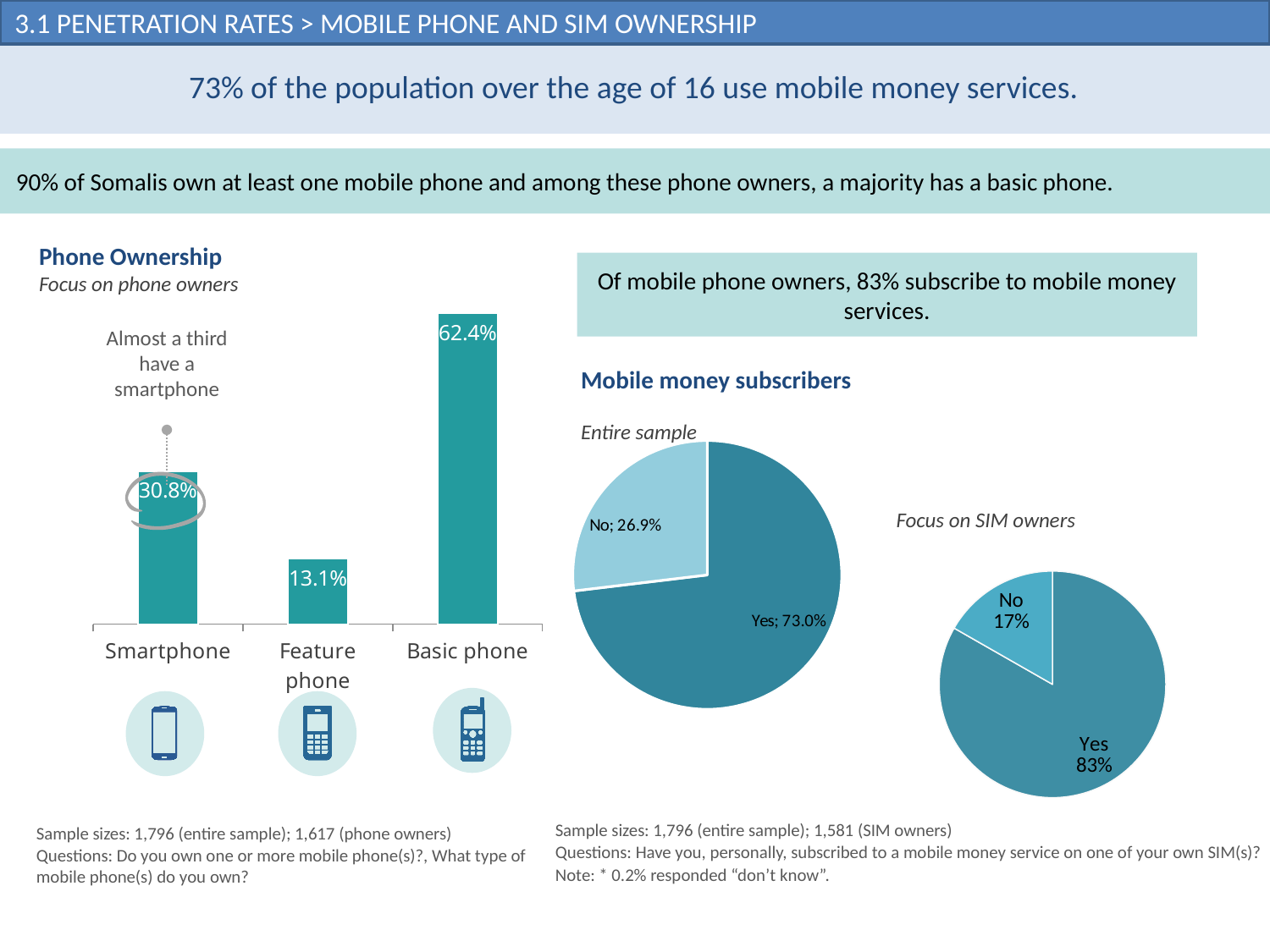
In the Phone Ownership bar chart, which phone type has the highest share? Basic phone In the Phone Ownership bar chart, what is the value for Feature phone? 13.1% In the Phone Ownership bar chart, how many phone types are shown? 3 In the Mobile money subscribers 'Entire sample' pie chart, what share answered No? 26.9% In the 'Focus on SIM owners' pie chart, which slice is larger, Yes or No? Yes In the 'Focus on SIM owners' pie chart, what share answered No? 17% What kind of chart is used for the 'Focus on SIM owners' data? Pie chart What kind of chart is the Phone Ownership chart? Bar chart In the Phone Ownership bar chart, what percentage of phone owners have a smartphone? 30.8% In the Phone Ownership bar chart, which phone type has the lowest share? Feature phone In the Mobile money subscribers 'Entire sample' pie chart, what share answered Yes? 73.0% In the Phone Ownership bar chart, what is the difference between the Basic phone and Smartphone values? 31.6%